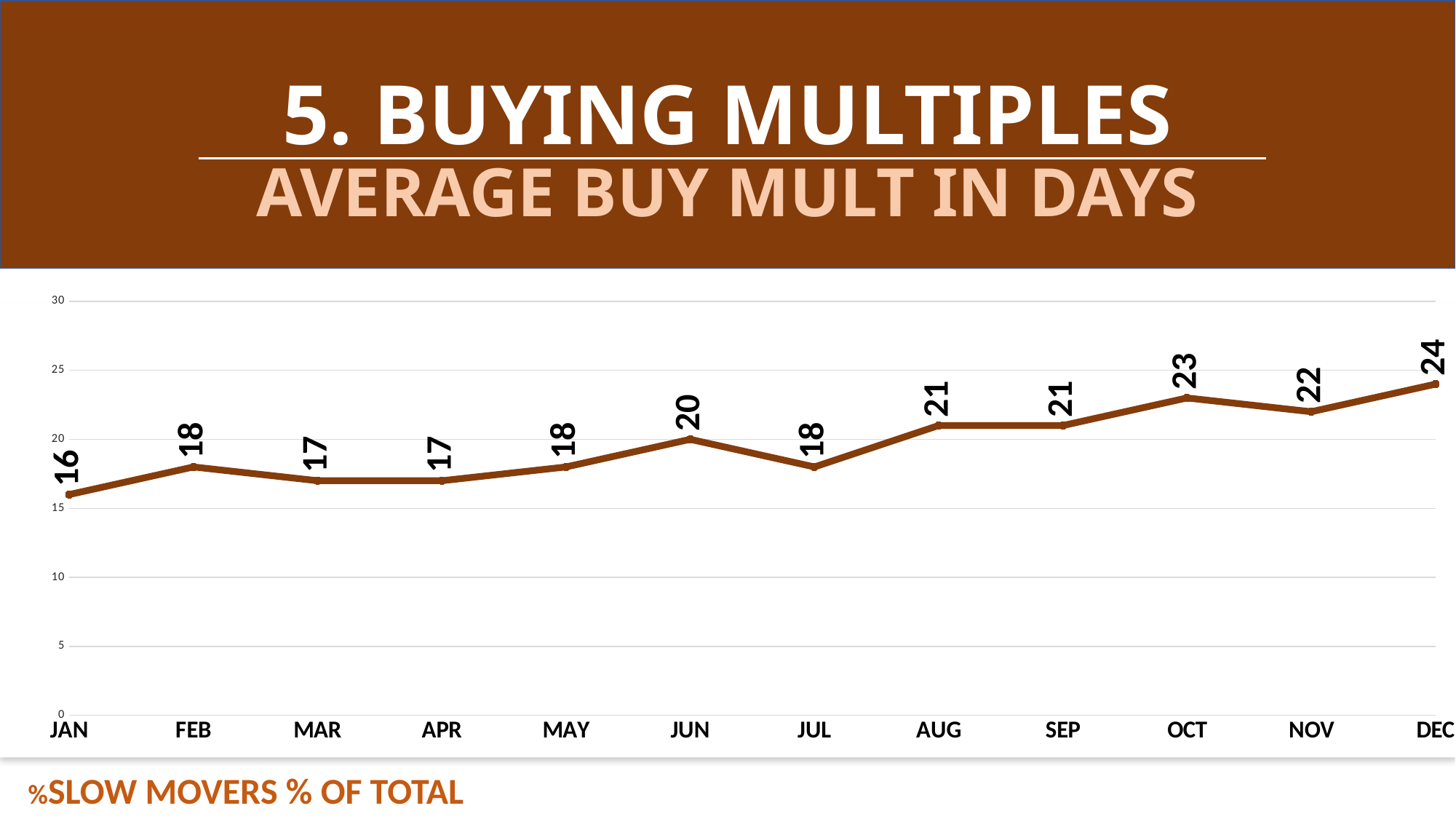
Which month has the highest value? DEC What is the difference between the JUN value and the JUL value? 2 How many months are plotted on the x axis? 12 What is the value for JUN? 20 What is the difference between the DEC value and the JAN value? 8 Do the values generally rise or fall from JAN to DEC? rise Which month has the lowest value? JAN What is the value for OCT? 23 Is the value for DEC greater or less than 20? greater What kind of chart is shown on the slide? line chart What is the average buy mult in days for JAN? 16 Which is larger, the value for OCT or the value for NOV? OCT